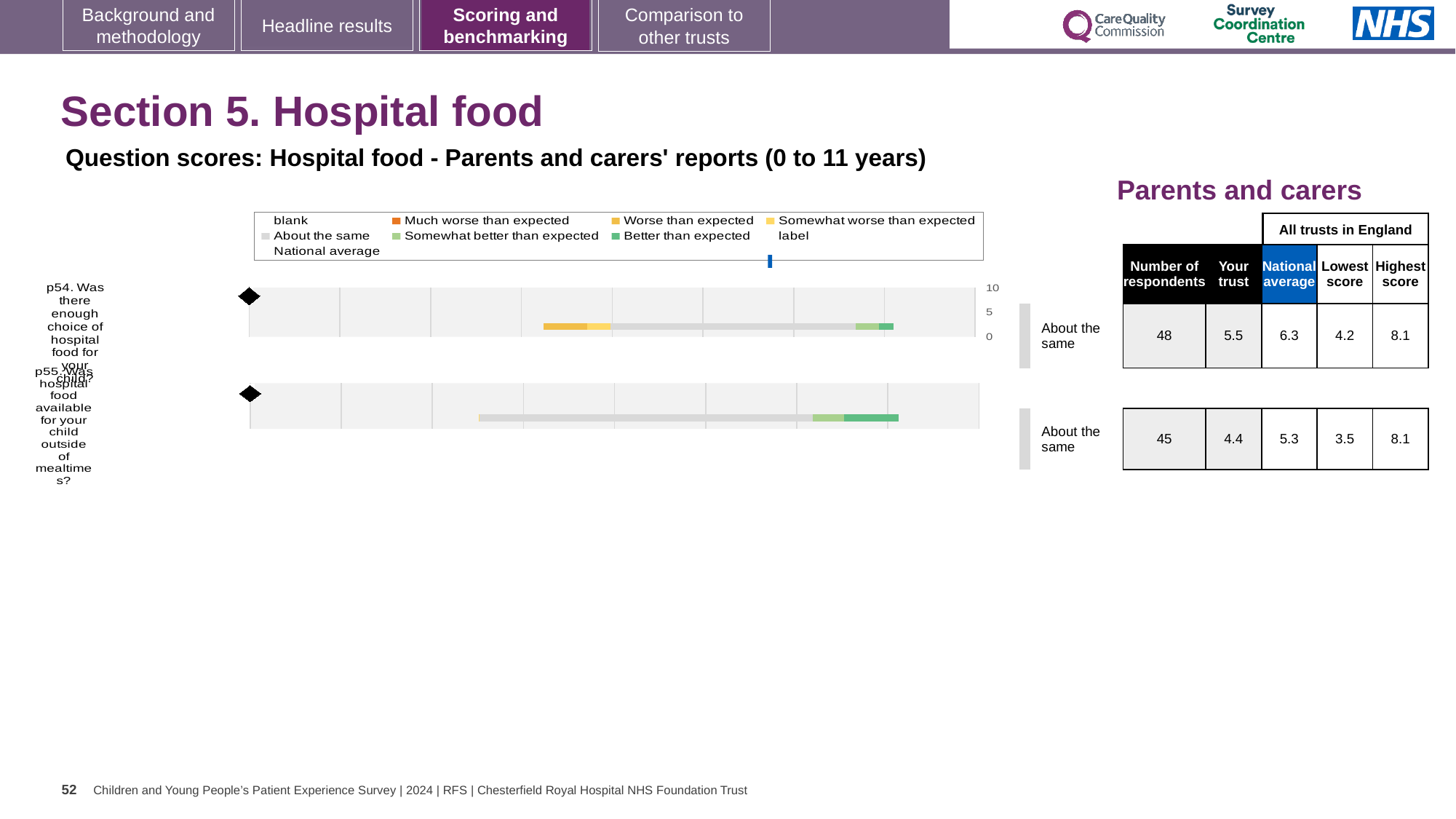
What is the lowest score among all trusts in England for p54? 4.2 What is the 'Your trust' score for p54 (enough choice of hospital food for your child)? 5.5 How many questions (categories) are plotted in the hospital food chart? 2 What is the difference between the national average and the 'Your trust' score for p54? 0.8 Which question has the higher 'Your trust' score, p54 or p55? p54 What is the difference between the national average and the 'Your trust' score for p55? 0.9 What is the national average score for p55 (hospital food available outside of mealtimes)? 5.3 How many respondents answered question p54? 48 What benchmark category label is shown next to both p54 and p55? About the same What colour does the legend use for 'Much worse than expected'? orange What is the highest score among all trusts in England for p55? 8.1 What kind of chart is used to show the question scores for hospital food? bar chart